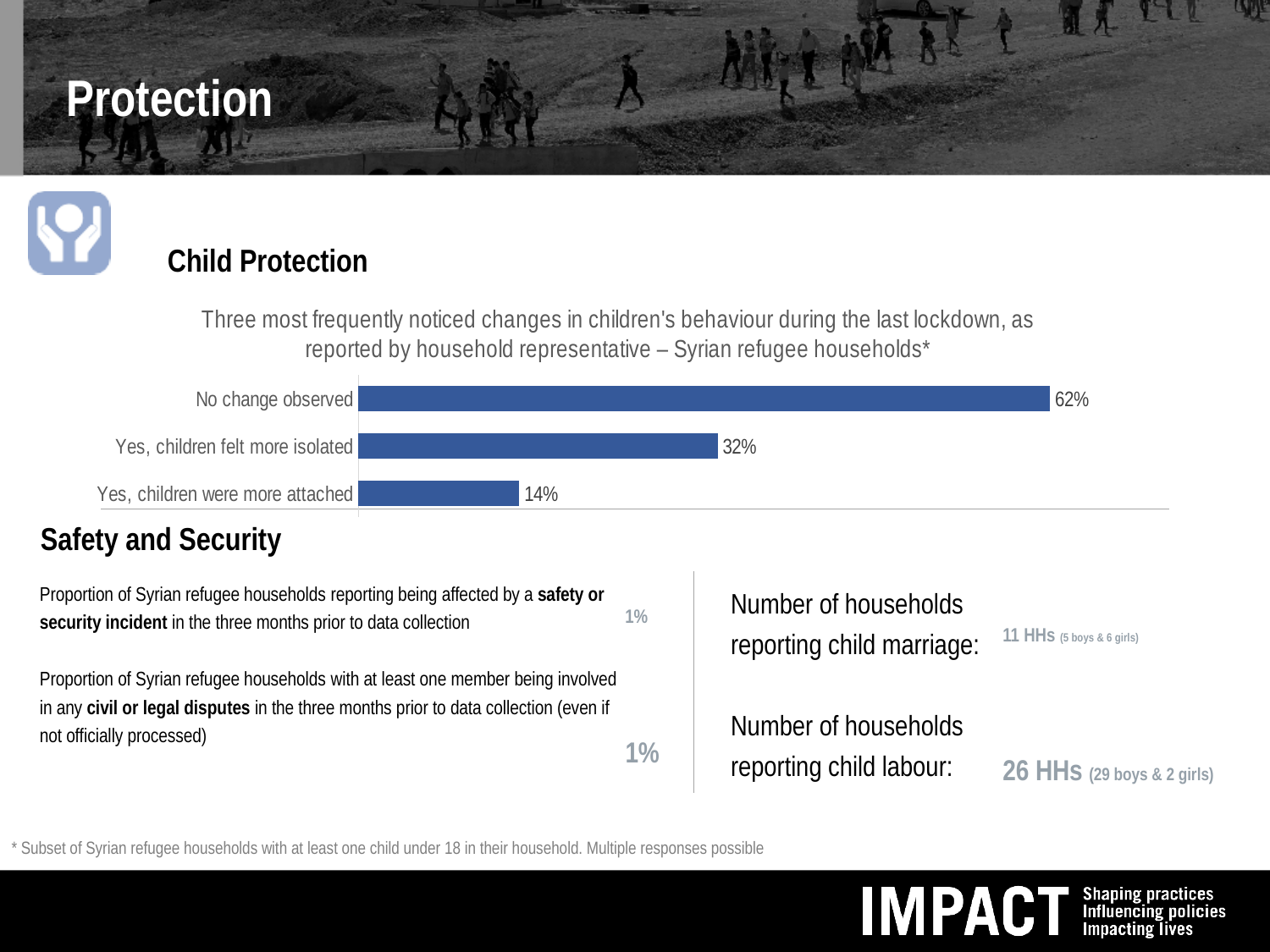
What is the difference between the values for 'No change observed' and 'Yes, children felt more isolated'? 30% What is the difference between the values for 'Yes, children felt more isolated' and 'Yes, children were more attached'? 18% What kind of chart is shown on the slide? Bar chart Which category has the highest value in the chart? No change observed What percentage of households reported 'Yes, children were more attached'? 14% How many categories are shown in the chart? 3 Which category has the lowest value in the chart? Yes, children were more attached What percentage of households reported 'No change observed'? 62% What percentage of households reported 'Yes, children felt more isolated'? 32% What is the title of the chart? Three most frequently noticed changes in children's behaviour during the last lockdown, as reported by household representative – Syrian refugee households* What colour are the bars in the chart? Blue Which is larger: the value for 'Yes, children felt more isolated' or 'Yes, children were more attached'? Yes, children felt more isolated